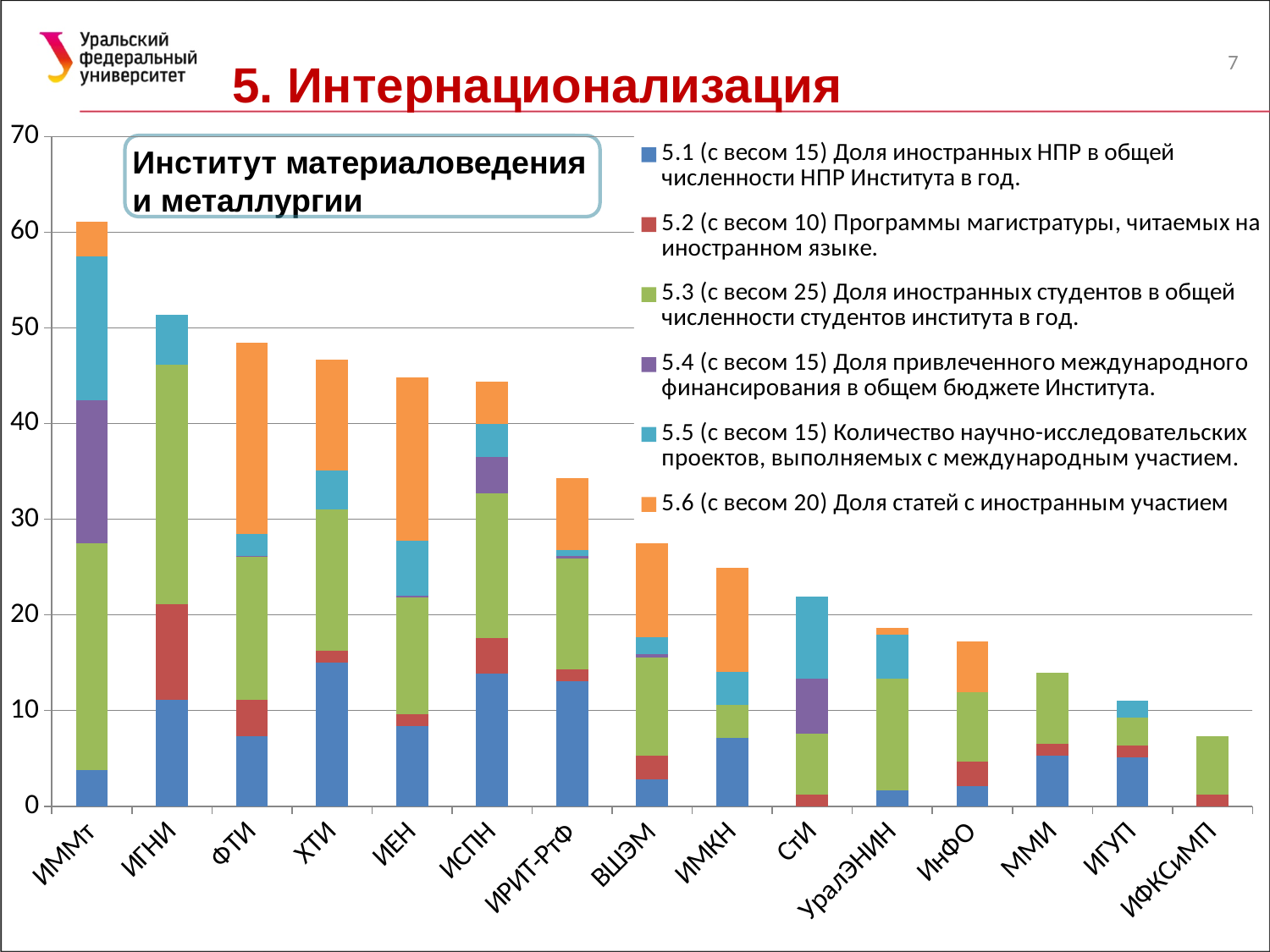
What kind of chart is shown on the slide? Stacked bar chart Which institute has the highest total stacked bar? ИММт How many institutes (categories) are shown along the x axis of the chart? 15 Which institute has the lowest total stacked bar? ИФКСиМП Is the total value for ИнФО greater or less than 20? less Do the total bar heights generally rise or fall from left to right along the x axis? Fall Is the total value for ИММт greater or less than 50? greater Is the total value for ИФКСиМП greater or less than 10? less How many series does the chart's legend list? 6 Which legend entry is shown in orange? 5.6 (с весом 20) Доля статей с иностранным участием What institute name is written in the text box at the top left of the chart? Институт материаловедения и металлургии Which has the larger total bar, ИСПН or ИРИТ-РтФ? ИСПН